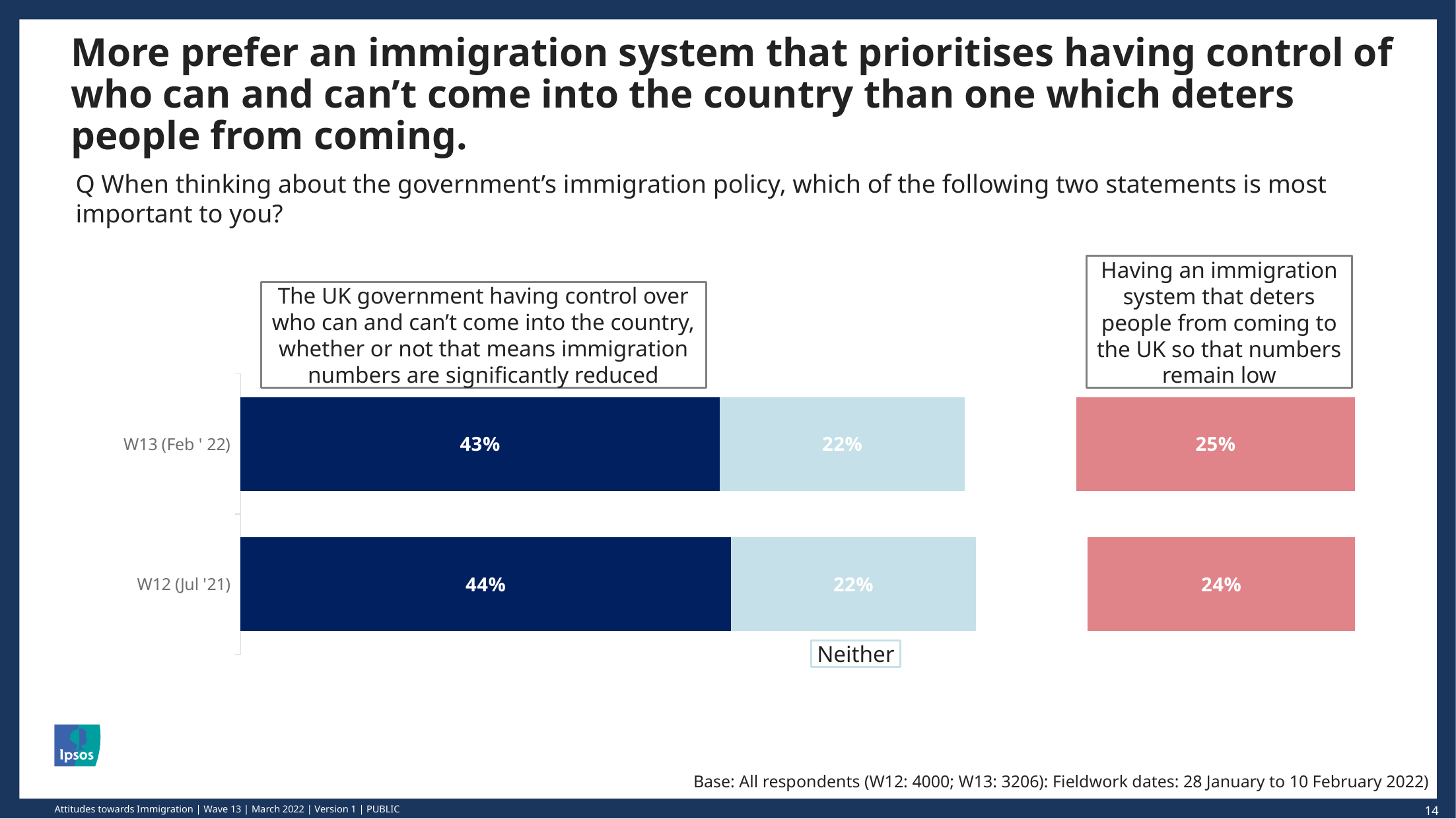
What percentage of W13 (Feb '22) respondents answered 'Neither'? 22% How many response options (series) are shown in the chart? 3 What is the difference between the share choosing 'The UK government having control' in W12 (Jul '21) and in W13 (Feb '22)? 1 percentage point What percentage of W12 (Jul '21) respondents chose 'Having an immigration system that deters people from coming to the UK so that numbers remain low'? 24% How many waves (categories) are shown on the chart? 2 Which response option has the highest share in W13 (Feb '22)? The UK government having control over who can and can't come into the country What percentage of W12 (Jul '21) respondents chose 'The UK government having control over who can and can't come into the country'? 44% Which wave has the higher share choosing 'Having an immigration system that deters people from coming to the UK', W13 (Feb '22) or W12 (Jul '21)? W13 (Feb '22) What is the difference between the share choosing 'The UK government having control' and the share choosing 'Having an immigration system that deters people' in W13 (Feb '22)? 18 percentage points What percentage of W13 (Feb '22) respondents chose 'The UK government having control over who can and can't come into the country'? 43% What type of chart is shown on the slide? Stacked bar chart Which response option has the lowest share in W12 (Jul '21)? Neither